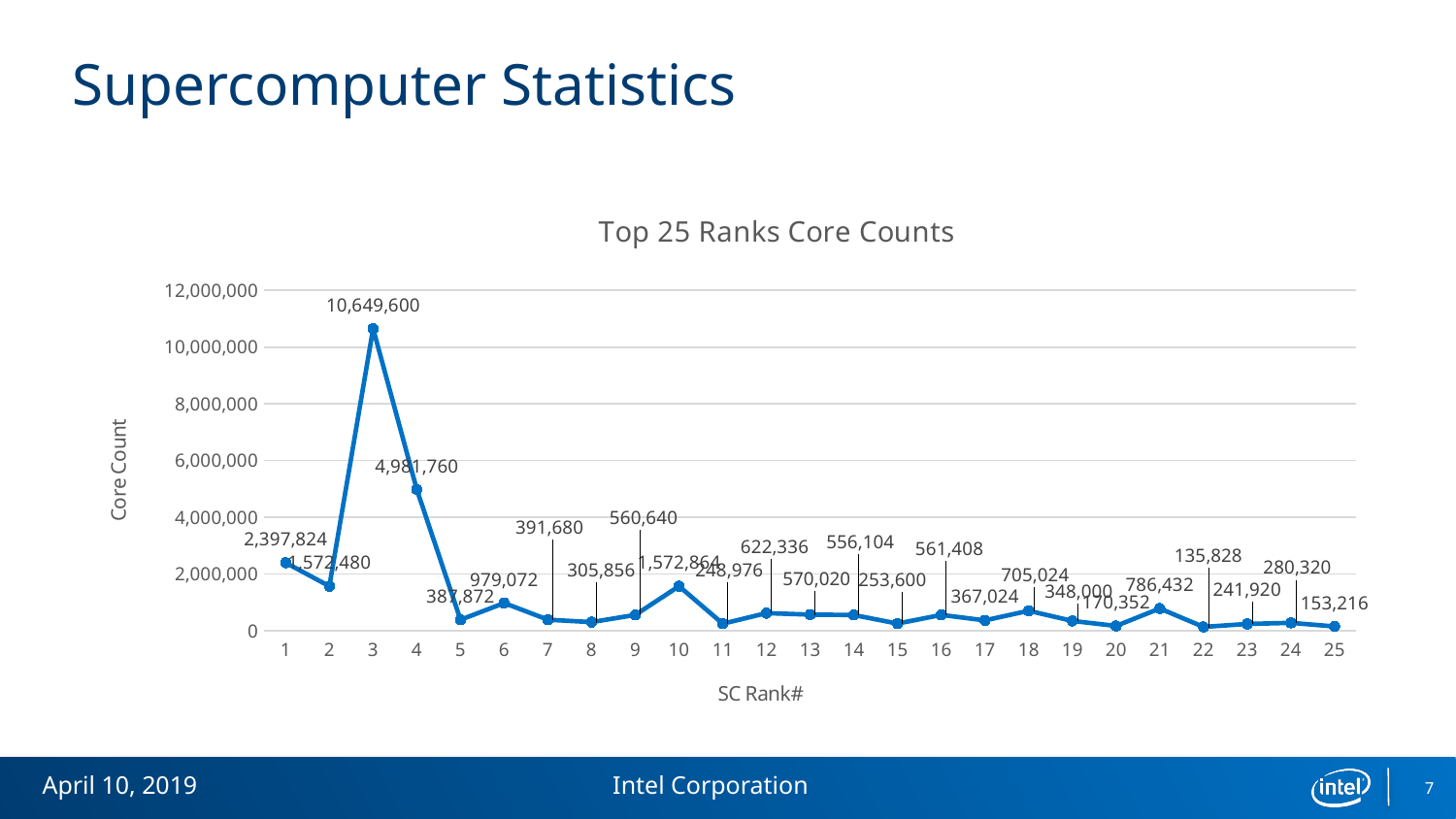
How many ranks are plotted on the chart? 25 Which has a larger core count, SC Rank# 1 or SC Rank# 2? SC Rank# 1 Which SC Rank# has the lowest core count? 22 What kind of chart is shown on the slide? line chart What is the core count for SC Rank# 25? 153,216 What is the core count for SC Rank# 3? 10,649,600 What is the core count for SC Rank# 4? 4,981,760 What is the difference in core count between SC Rank# 3 and SC Rank# 4? 5,667,840 Which SC Rank# has the highest core count? 3 What is the core count for SC Rank# 1? 2,397,824 What is the core count for SC Rank# 21? 786,432 Is the core count for SC Rank# 3 greater or less than 10,000,000? greater